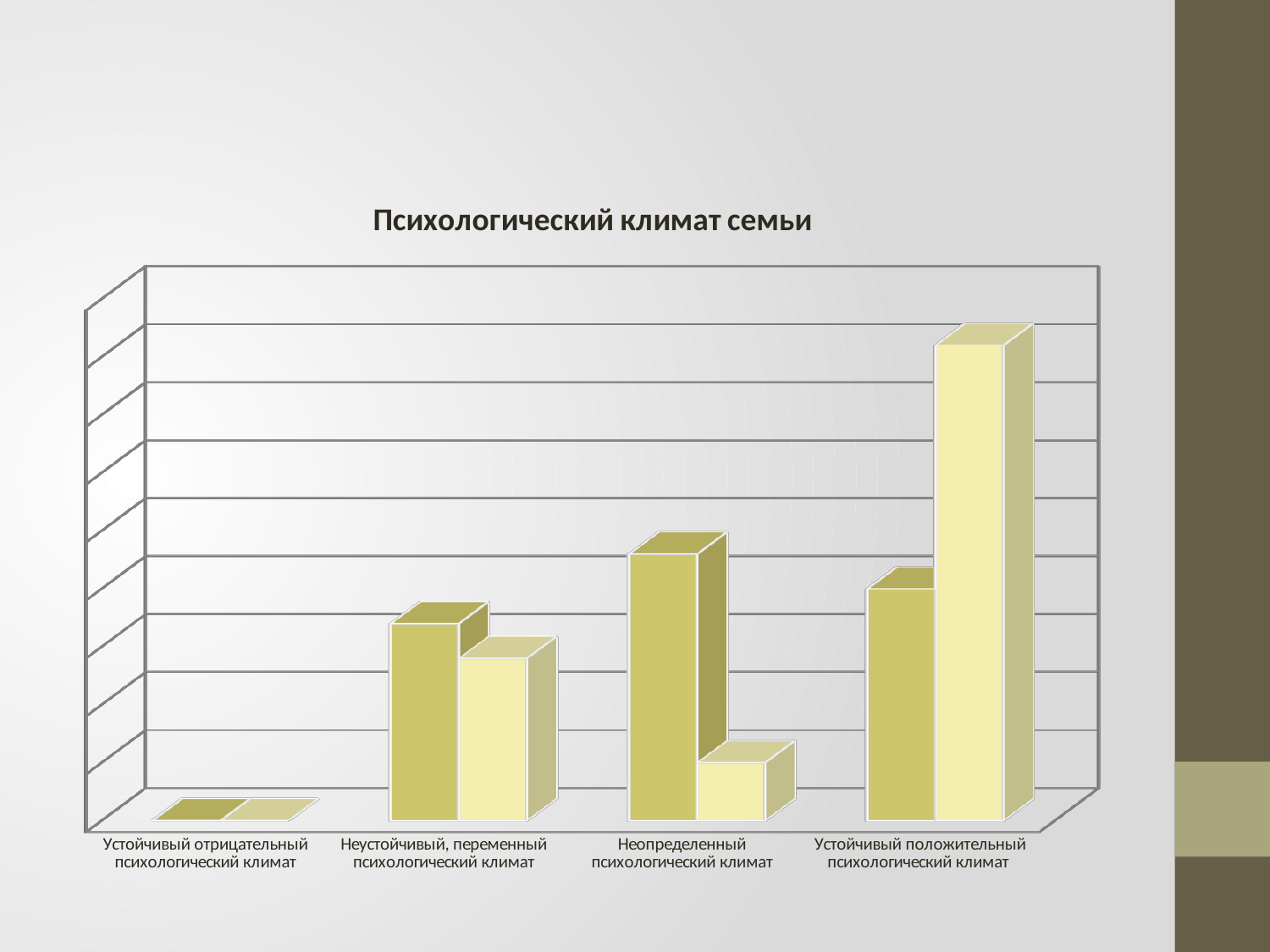
Comparing the lighter (second) bars, which is taller: Неустойчивый, переменный психологический климат or Неопределенный психологический климат? Неустойчивый, переменный психологический климат Which category has the lowest bars in the chart? Устойчивый отрицательный психологический климат How many bars are plotted for each category in the chart? 2 Comparing the darker (first) bars, which is taller: Неустойчивый, переменный психологический климат or Неопределенный психологический климат? Неопределенный психологический климат What is the title of the chart? Психологический климат семьи How many categories are shown along the x axis of the chart? 4 For Неопределенный психологический климат, which bar is taller: the darker first bar or the lighter second bar? The darker first bar What kind of chart is shown on the slide? Bar chart Does the chart display a legend? No Which category has the tallest bar in the chart? Устойчивый положительный психологический климат Which category has the tallest darker (first) bar? Неопределенный психологический климат